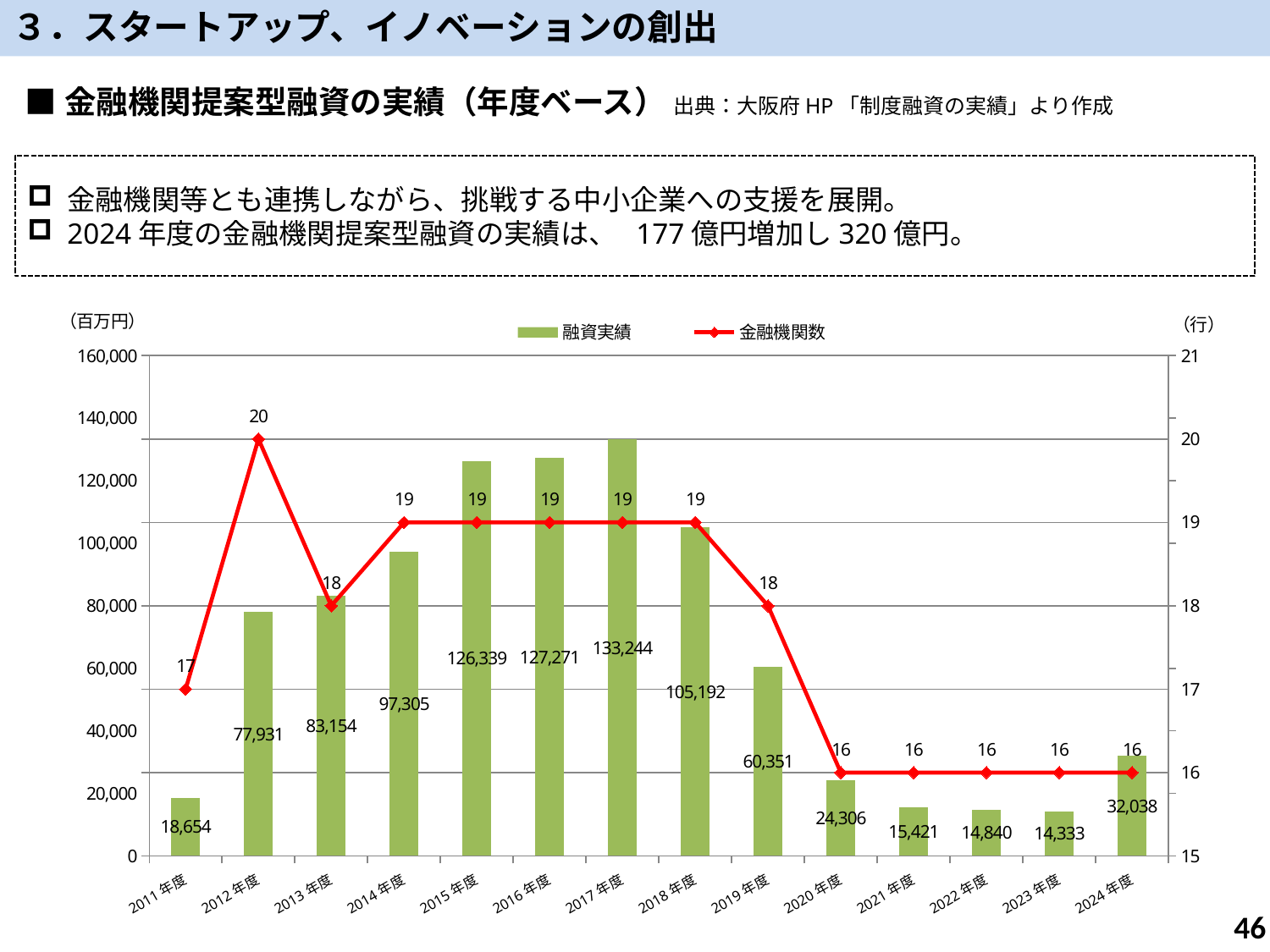
In which year is 金融機関数 highest? 2012年度 Which year has the highest 融資実績? 2017年度 Which is larger, the 融資実績 for 2015年度 or for 2016年度? 2016年度 What is the difference in 融資実績 between 2024年度 and 2023年度? 17,705 Which year has the lowest 融資実績? 2023年度 What kind of chart is shown? Combined bar and line chart Does 融資実績 rise or fall from 2020年度 to 2023年度? Fall What is the 融資実績 value for 2017年度? 133,244 How many fiscal years are shown on the x axis? 14 How many series does the legend list? 2 What is the 融資実績 value for 2024年度? 32,038 What is the 金融機関数 value for 2019年度? 18